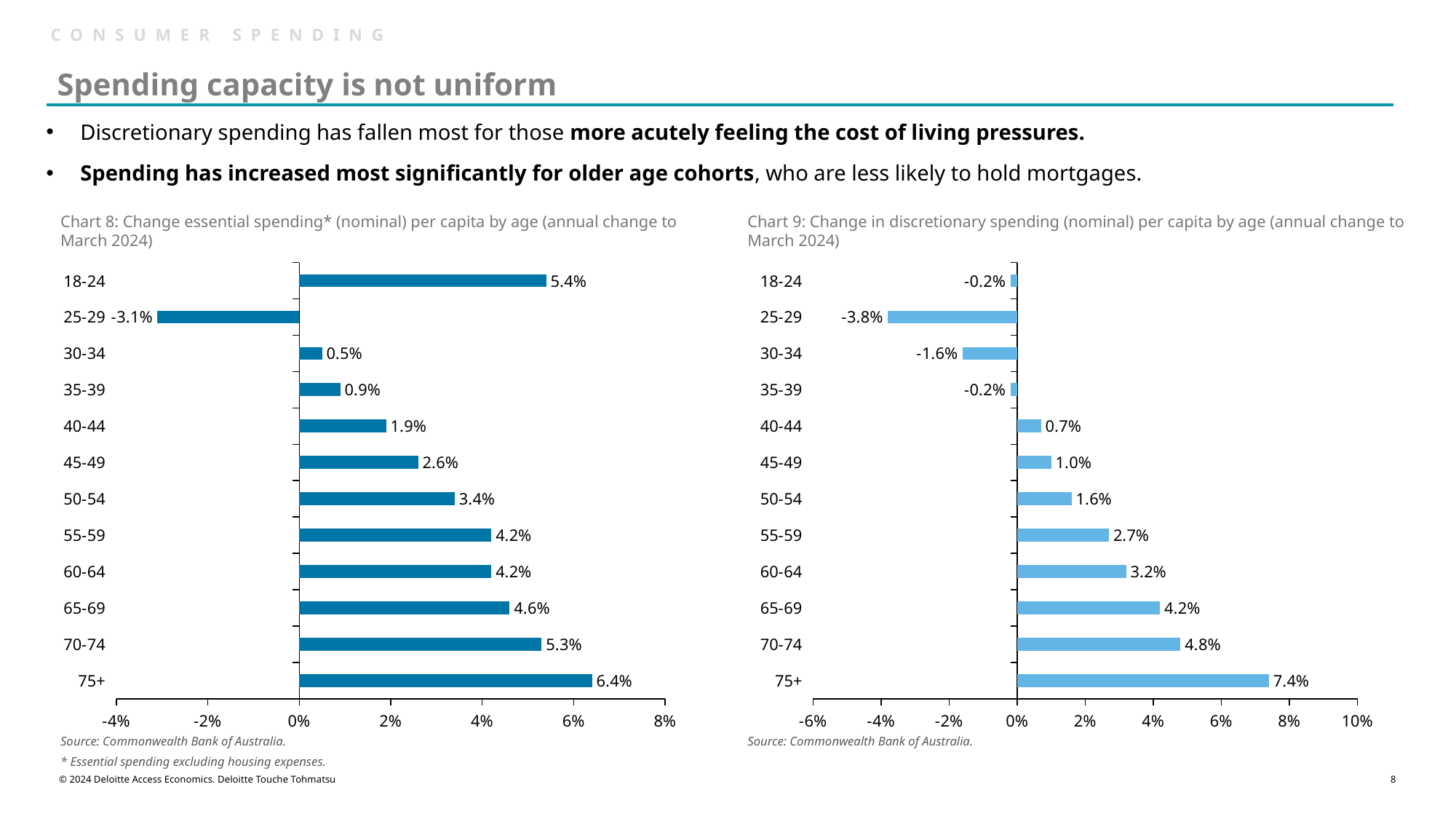
In Chart 9 (change in discretionary spending), do the values generally rise or fall from the 40-44 group to the 75+ group? Rise In Chart 8 (change in essential spending), what is the value for the 18-24 age group? 5.4% In Chart 8 (change in essential spending), which age group has the highest value? 75+ What type of chart is Chart 9 (change in discretionary spending)? Bar chart In Chart 8 (change in essential spending), what is the difference between the values for 75+ and 70-74? 1.1% In Chart 8 (change in essential spending), how many age groups are shown? 12 In Chart 9 (change in discretionary spending), what is the difference between the values for 75+ and 70-74? 2.6% In Chart 9 (change in discretionary spending), what is the value for the 25-29 age group? -3.8% In Chart 9 (change in discretionary spending), which is larger: the value for 60-64 or the value for 65-69? 65-69 In Chart 9 (change in discretionary spending), which age group has the highest value? 75+ In Chart 8 (change in essential spending), which age group has the lowest value? 25-29 In Chart 9 (change in discretionary spending), which age group has the lowest value? 25-29